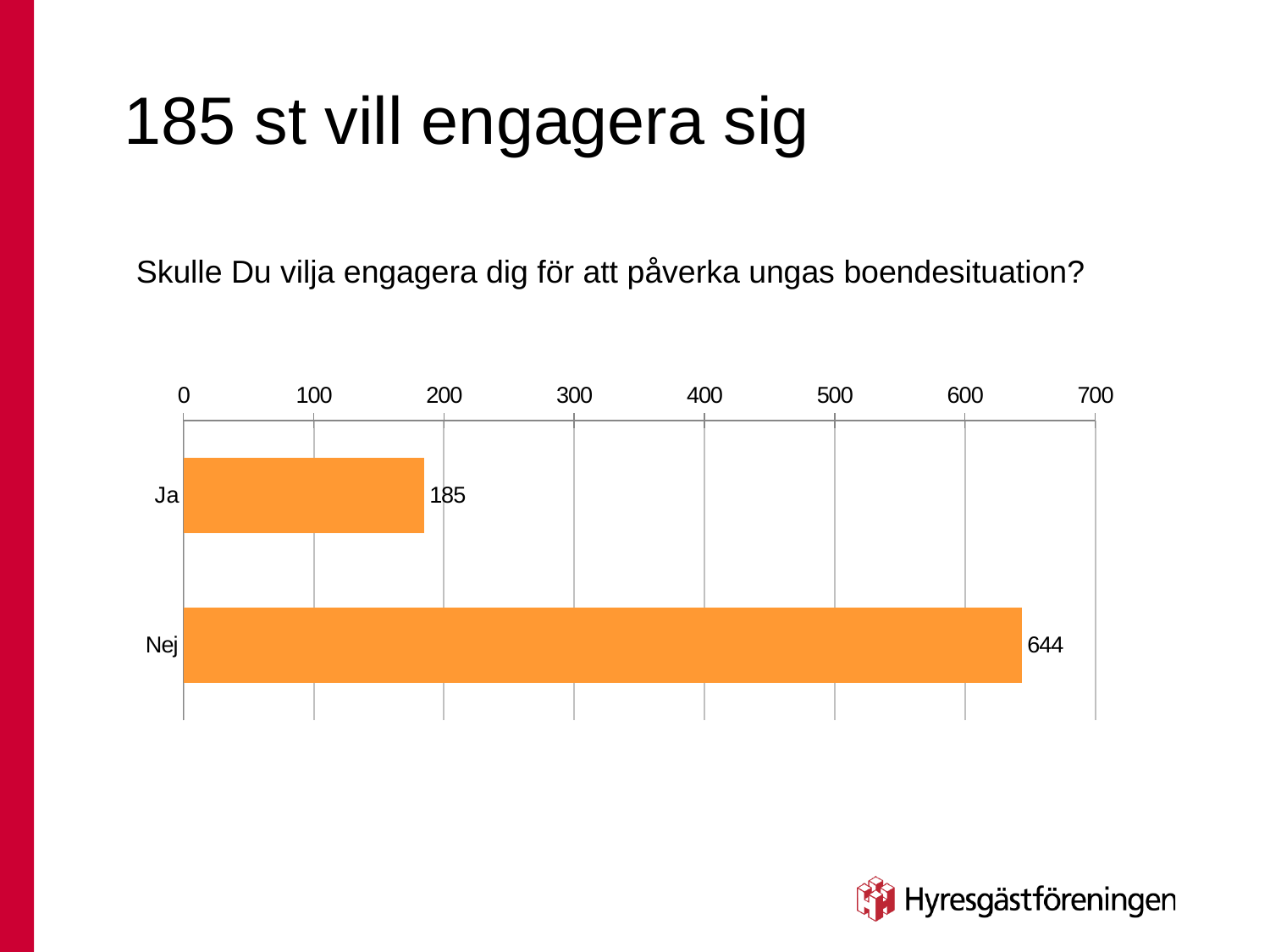
Which category has the highest value? Nej What is the value for Ja? 185 Is the value for Ja greater or less than 200? less What is the value for Nej? 644 Is the value for Nej greater or less than 600? greater What is the difference between the values for Nej and Ja? 459 What kind of chart is shown on the slide? bar chart What is the highest value shown on the value axis? 700 Which is larger, the value for Ja or the value for Nej? Nej Which category has the lowest value? Ja How many categories are shown in the chart? 2 What is the total of the values for Ja and Nej? 829